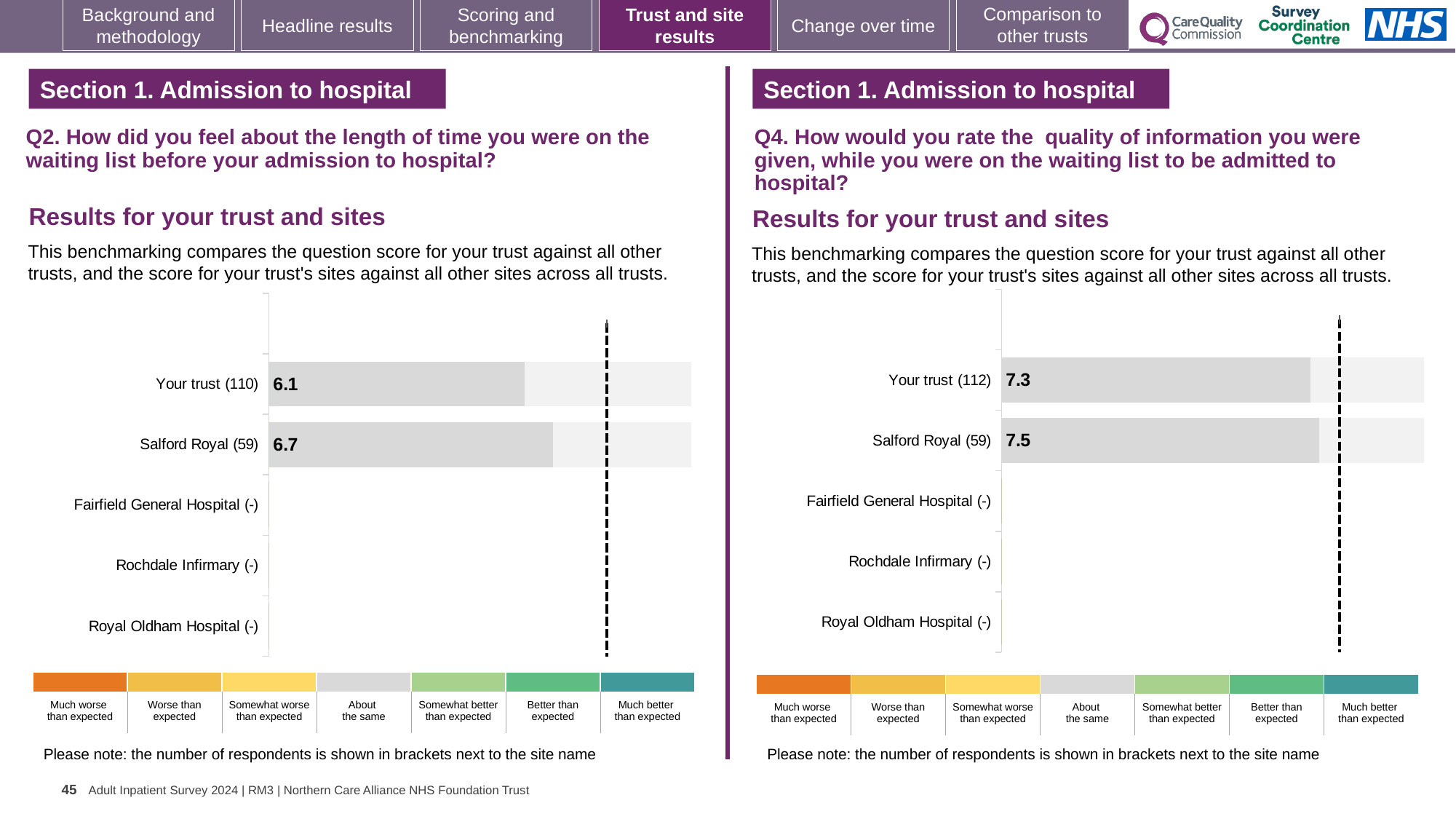
In the Q4 chart on the right, what is the score for Your trust (112)? 7.3 In the Q4 chart on the right, what is the score for Salford Royal (59)? 7.5 In the Q2 chart on the left, what is the score for Your trust (110)? 6.1 What type of chart is used in the Q4 chart on the right? Bar chart In the Q4 chart on the right, which has the higher score, Your trust or Salford Royal? Salford Royal In the Q2 chart on the left, which has the higher score, Your trust or Salford Royal? Salford Royal In the Q2 chart on the left, what is the score for Salford Royal (59)? 6.7 In the Q2 chart on the left, how many respondents are shown in brackets for Your trust? 110 How many site/trust categories are listed on the y axis of the Q2 chart on the left? 5 In the Q2 chart on the left, what is the difference between the Salford Royal score and the Your trust score? 0.6 In the Q4 chart on the right, how many respondents are shown in brackets for Your trust? 112 In the Q4 chart on the right, what is the difference between the Salford Royal score and the Your trust score? 0.2